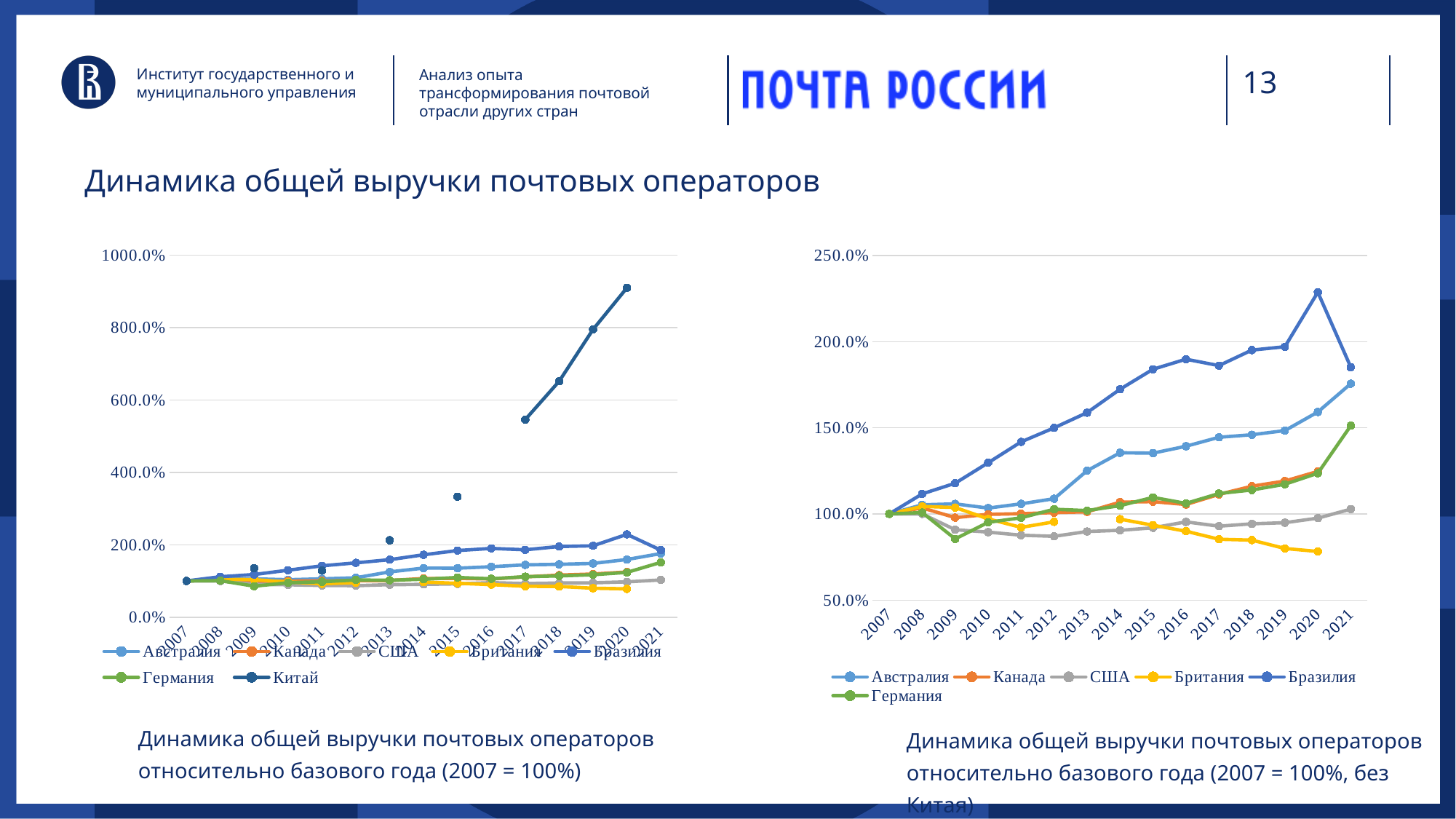
In the left chart, which series has the highest value in 2021? Бразилия How many series does the legend of the left chart list? 7 In the right chart, is the value for Британия in 2020 greater or less than 100.0%? less What kind of chart is the left chart on the slide? line chart How many years are shown on the x axis of the right chart? 15 In the right chart, is the value for Бразилия in 2020 greater or less than 200.0%? greater In the right chart, which series has the lowest value in 2020? Британия In the right chart, what is the value for Бразилия in 2007? 100.0% In the right chart, which is larger in 2021: Австралия or Германия? Австралия In the right chart, does the value for Британия rise or fall from 2007 to 2020? fall How many series does the legend of the right chart (без Китая) list? 6